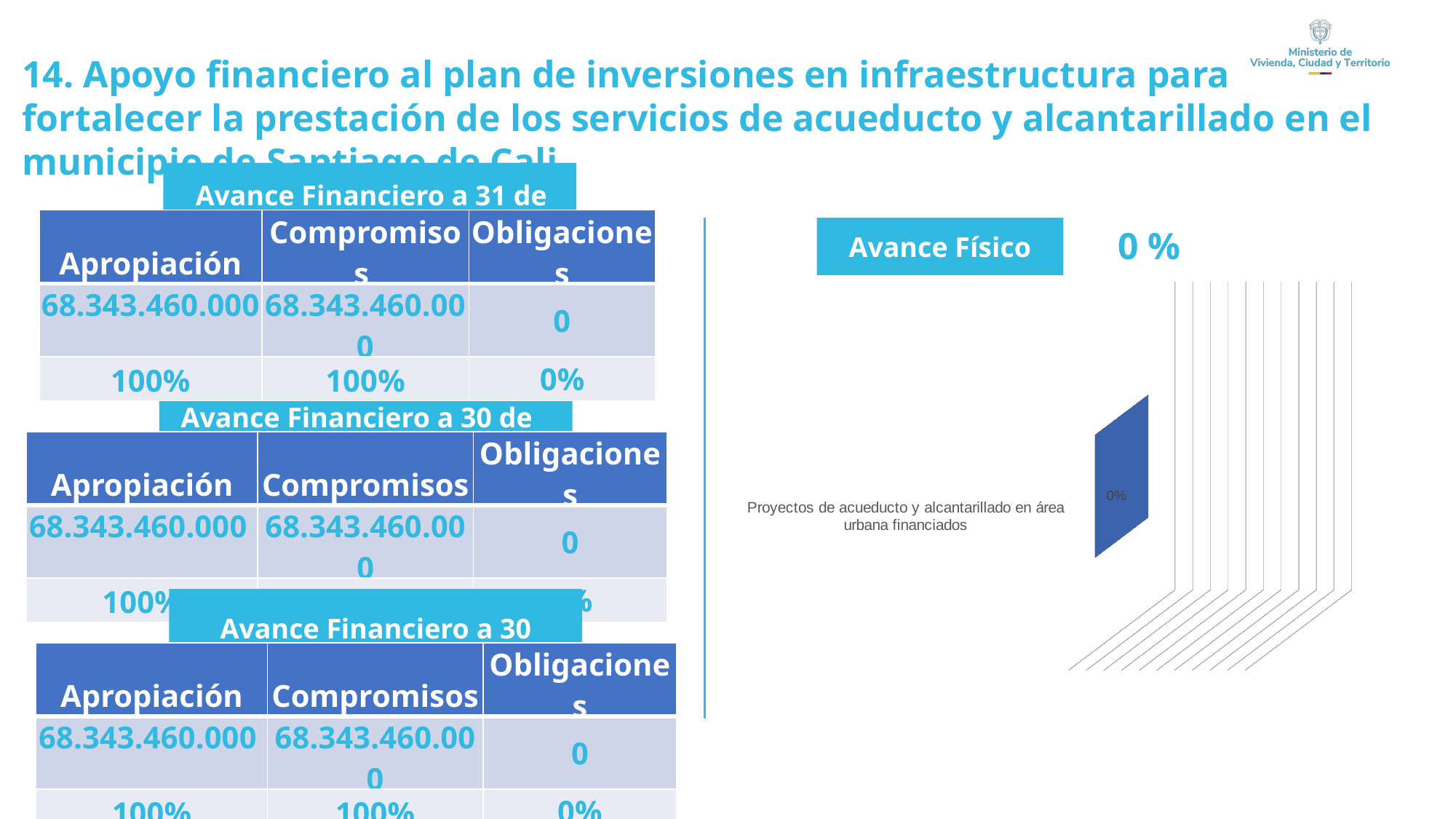
What kind of chart is shown under the Avance Físico heading? bar chart In the Avance Físico chart, what value is shown for 'Proyectos de acueducto y alcantarillado en área urbana financiados'? 0% What overall percentage is displayed next to the Avance Físico heading above the chart? 0 % What is the label of the only category in the Avance Físico chart? Proyectos de acueducto y alcantarillado en área urbana financiados How many categories are plotted in the Avance Físico chart? 1